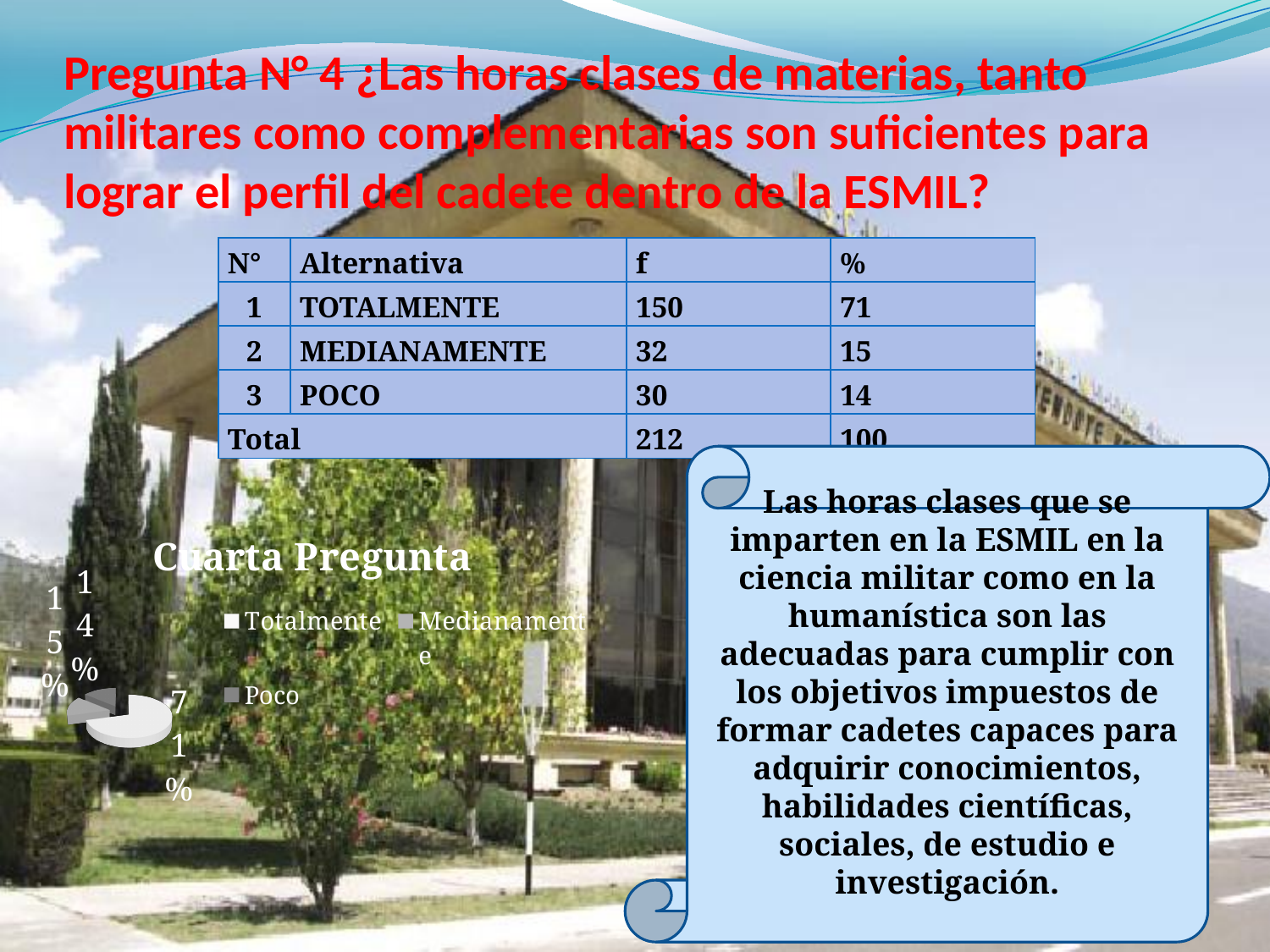
Which is larger in the pie chart, the Totalmente slice or the Medianamente slice? Totalmente What kind of chart is shown on the slide? pie chart Which is larger in the pie chart, the Totalmente slice or the Poco slice? Totalmente Is the share for Totalmente in the pie chart greater or less than 50%? greater What is the title of the chart on the slide? Cuarta Pregunta Which category has the largest slice in the pie chart? Totalmente What are the three legend entries of the chart, in order? Totalmente, Medianamente, Poco How many entries does the chart's legend list? 3 How many slices does the pie chart have? 3 What percentage does the chart show for Totalmente? 71%